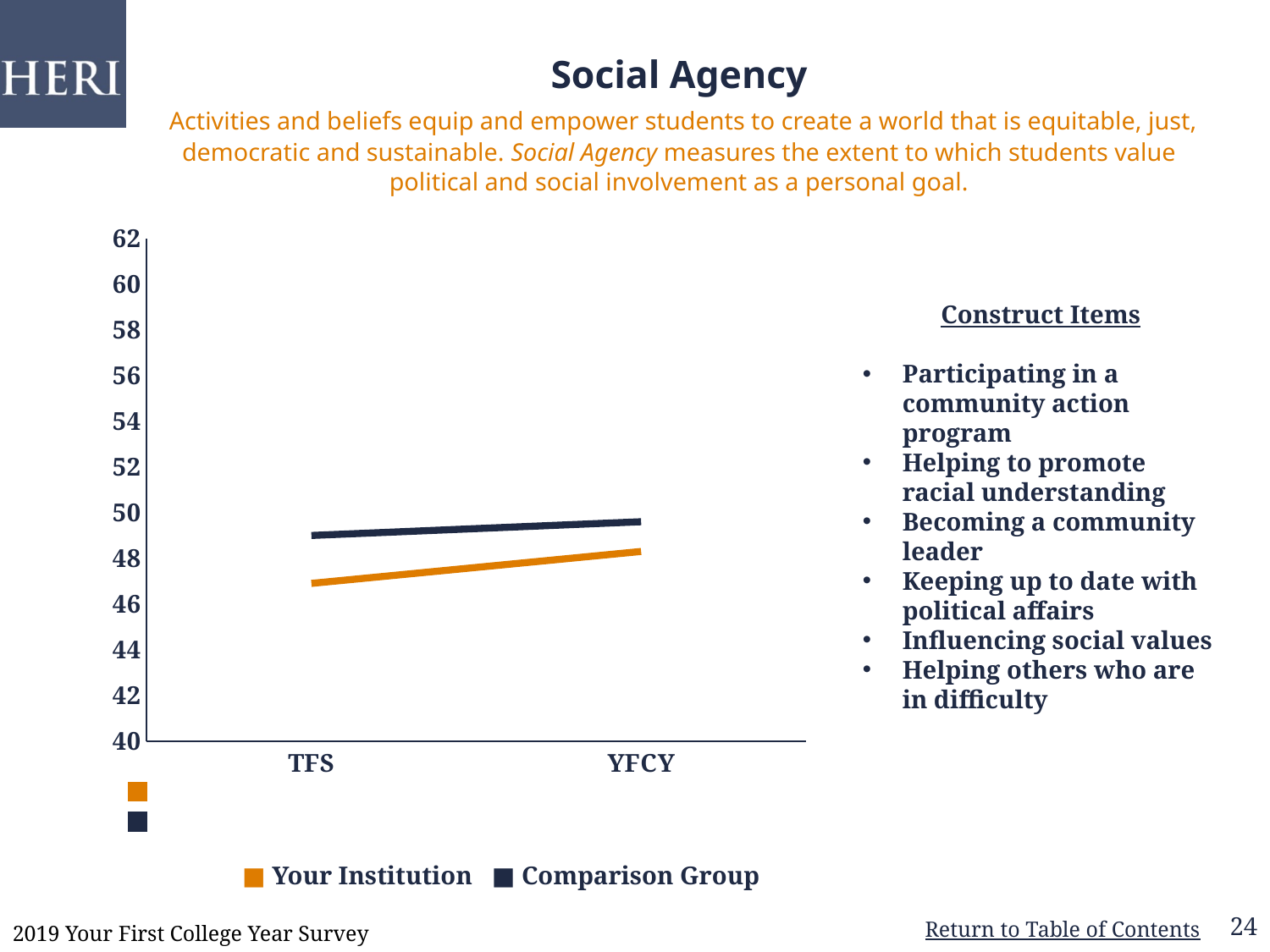
What kind of chart is shown on the slide? line chart How many series does the chart legend list? 2 Which series is shown in orange in the chart legend? Your Institution Is the value for Comparison Group at TFS greater or less than 48? greater Does the Your Institution line rise or fall from TFS to YFCY? rise At TFS, which is higher: Your Institution or Comparison Group? Comparison Group What is the title of the chart on the slide? Social Agency Is the value for Your Institution at TFS greater or less than 48? less Does the Comparison Group line rise or fall from TFS to YFCY? rise How many points are on the x axis of the chart? 2 At YFCY, which is higher: Your Institution or Comparison Group? Comparison Group Is the value for Comparison Group at YFCY greater or less than 50? less